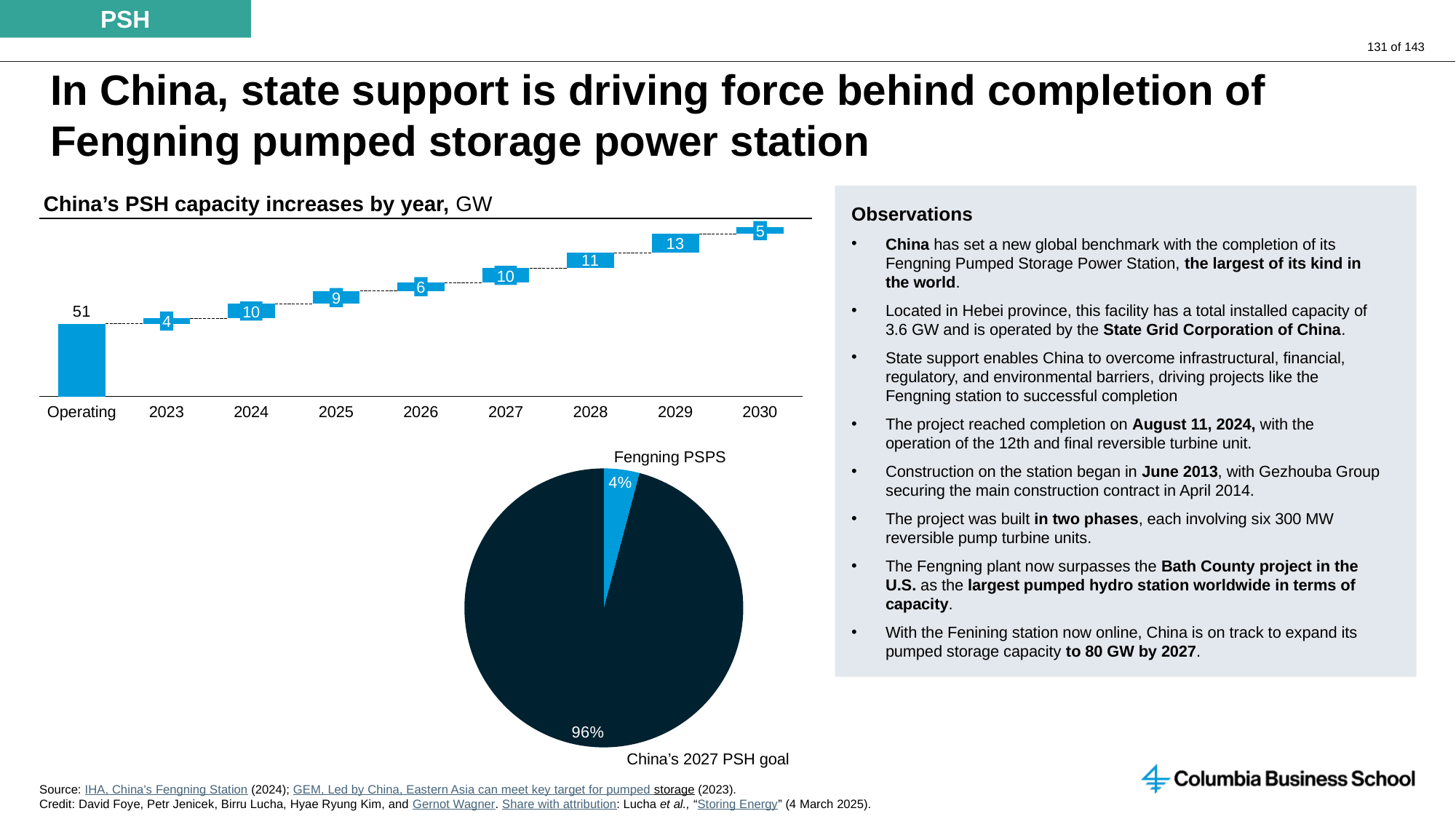
What unit is stated in the title of the chart 'China's PSH capacity increases by year'? GW In the chart 'China's PSH capacity increases by year', what is the value for 2029? 13 What kind of chart is the chart at the bottom of the slide showing Fengning PSPS and China's 2027 PSH goal? Pie chart How many categories are shown on the x axis of the chart 'China's PSH capacity increases by year'? 9 In the pie chart at the bottom of the slide, what share does Fengning PSPS represent? 4% In the chart 'China's PSH capacity increases by year', what is the value for 2026? 6 In the chart 'China's PSH capacity increases by year', which year from 2023 to 2030 has the smallest increase? 2023 In the chart 'China's PSH capacity increases by year', which year from 2023 to 2030 has the largest increase? 2029 In the chart 'China's PSH capacity increases by year', what is the difference between the values for 2029 and 2023? 9 In the pie chart at the bottom of the slide, what share does China's 2027 PSH goal represent? 96% In the chart 'China's PSH capacity increases by year', what is the value for Operating? 51 In the chart 'China's PSH capacity increases by year', which is larger, the value for 2028 or the value for 2030? 2028